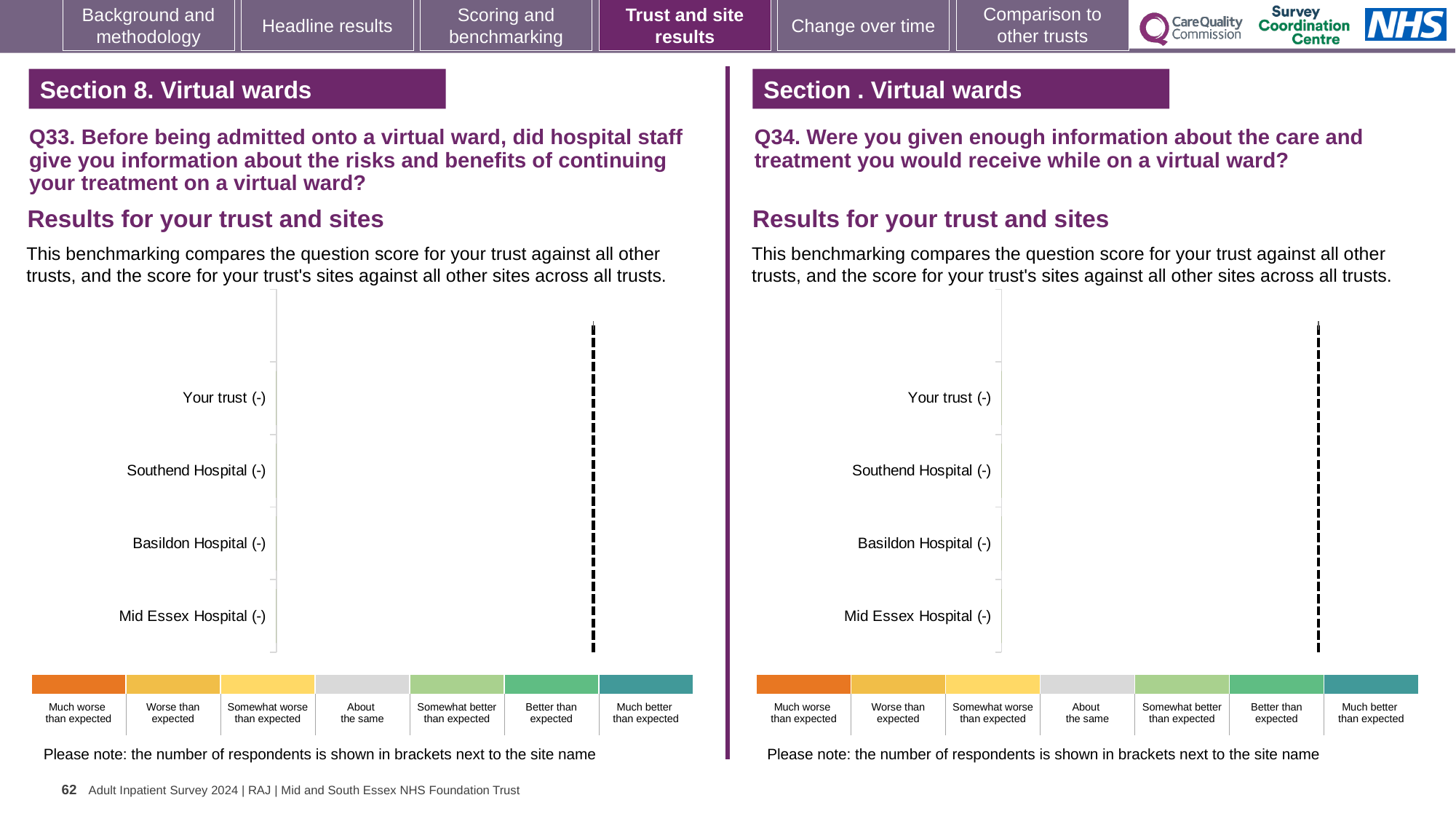
On the right chart (Q34), how many rating bands does the colour key below the chart show? 7 On the right chart (Q34), which category is listed at the bottom of the vertical axis? Mid Essex Hospital (-) On the right chart (Q34), are any bars plotted for the listed categories? No On the left chart (Q33), which category is listed at the top of the vertical axis? Your trust (-) On the left chart (Q33), what is shown in brackets next to 'Your trust'? - On the right chart (Q34), how many categories are listed on the vertical axis? 4 On the left chart (Q33), how many rating bands does the colour key below the chart show? 7 On the right chart (Q34), what is shown in brackets next to 'Mid Essex Hospital'? - On the left chart (Q33), how many categories are listed on the vertical axis? 4